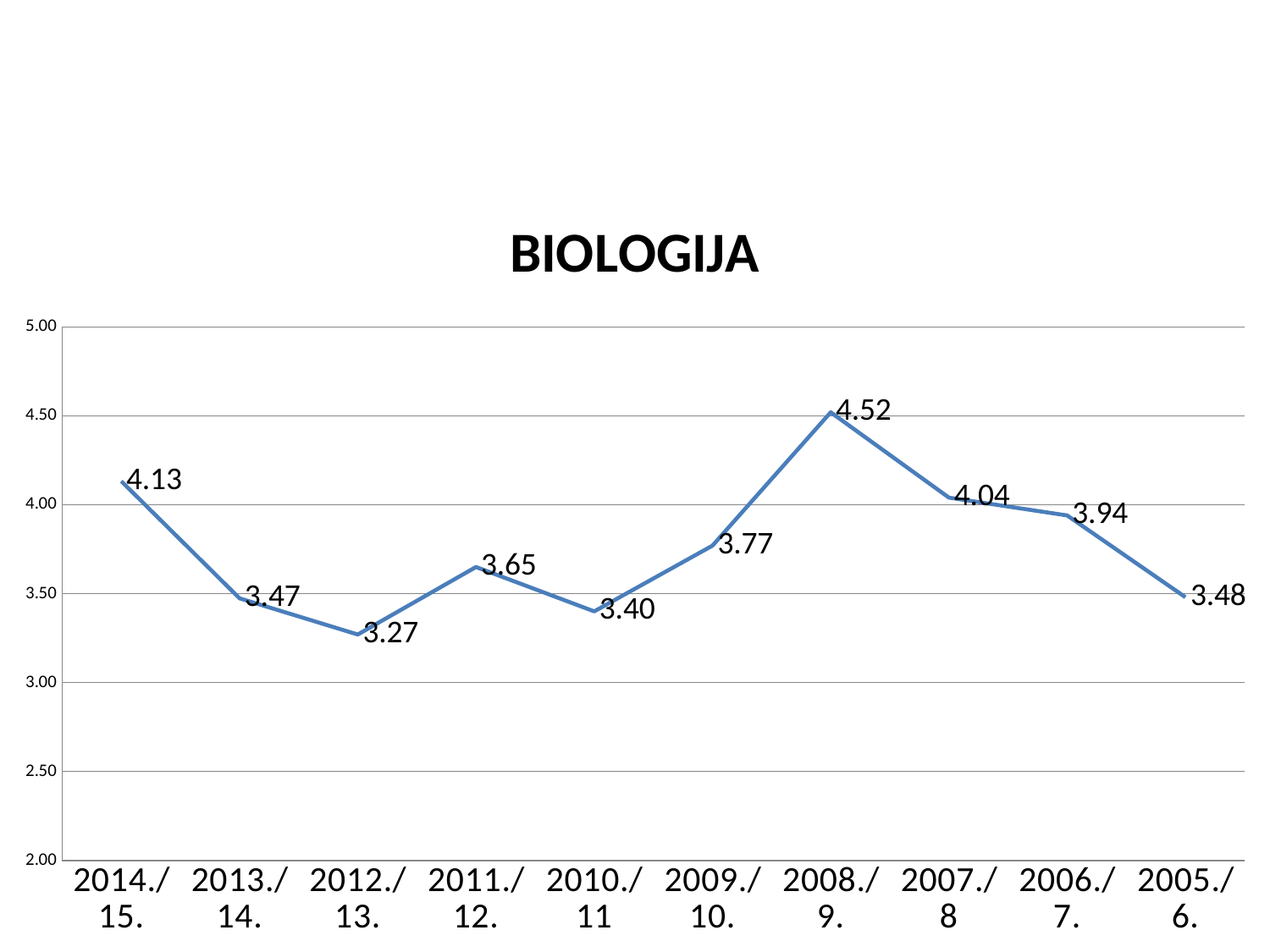
Which school year has the lowest value in the BIOLOGIJA chart? 2012./13. What kind of chart is shown on the slide? line chart What is the value for 2014./15. in the BIOLOGIJA chart? 4.13 What is the difference between the values for 2014./15. and 2013./14.? 0.66 How many school years are plotted in the BIOLOGIJA chart? 10 Is the value for 2009./10. greater or less than 4.00? less What is the value for 2008./9. in the BIOLOGIJA chart? 4.52 What is the value for 2010./11 in the BIOLOGIJA chart? 3.40 What is the difference between the values for 2008./9. and 2012./13.? 1.25 Which is larger, the value for 2007./8 or the value for 2006./7.? 2007./8 What is the title of the chart? BIOLOGIJA Which school year has the highest value in the BIOLOGIJA chart? 2008./9.